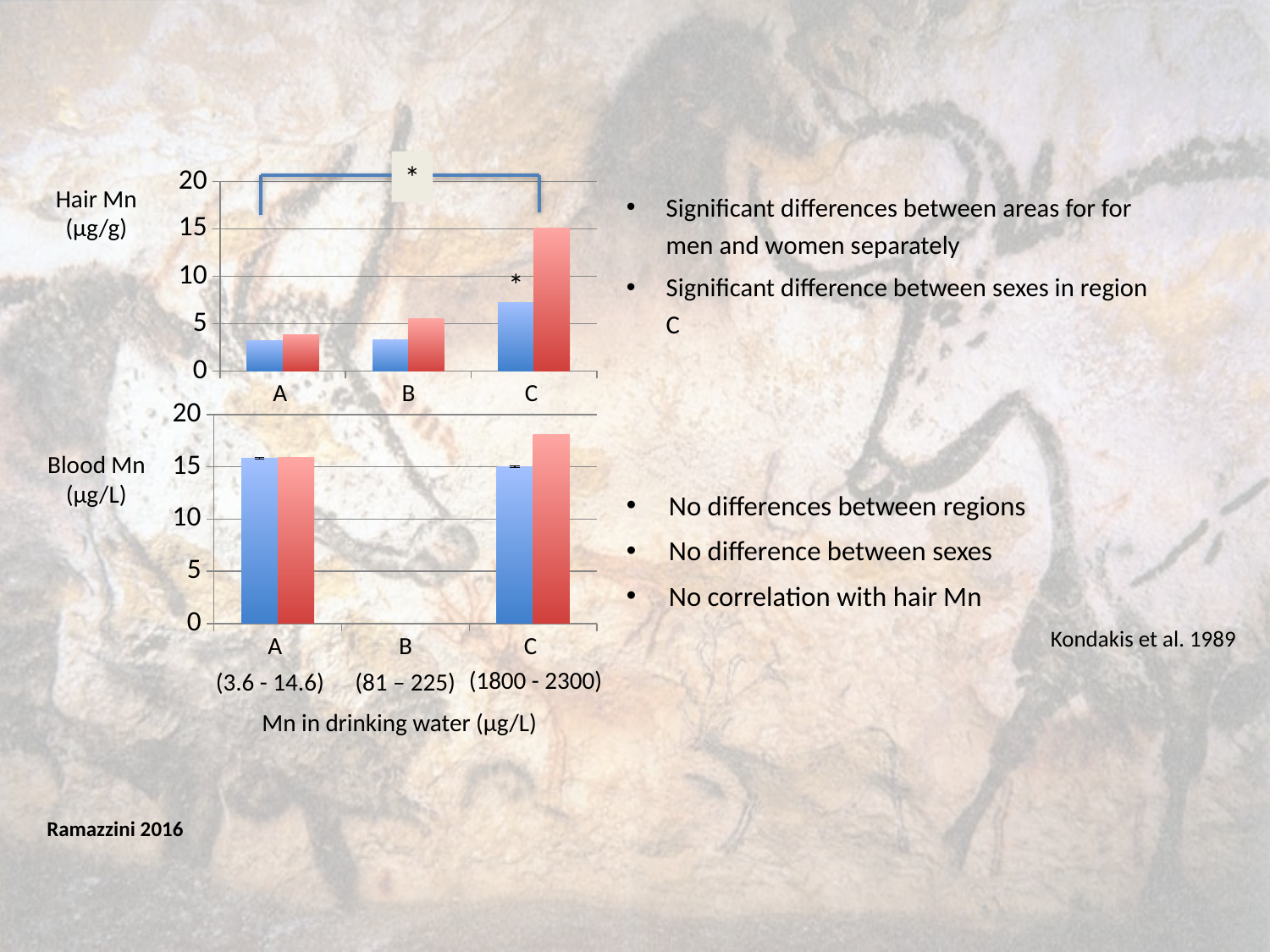
How many categories are shown on the x axis of the Hair Mn chart? 3 In the Blood Mn chart, is the blue bar for A greater or less than 15? greater In the Blood Mn chart, is the red bar for C greater or less than 15? greater What kind of chart is the Hair Mn chart at the top of the slide? bar chart In the Hair Mn chart, is the red bar for C greater or less than 10? greater What is the x-axis title shown below the Blood Mn chart? Mn in drinking water (µg/L) In the Blood Mn chart, which is larger for category C, the blue bar or the red bar? the red bar In the Hair Mn chart, do the red bars rise or fall from A to C? rise In the Hair Mn chart, which category has the tallest red bar? C In the Hair Mn chart, which is larger for category C, the blue bar or the red bar? the red bar